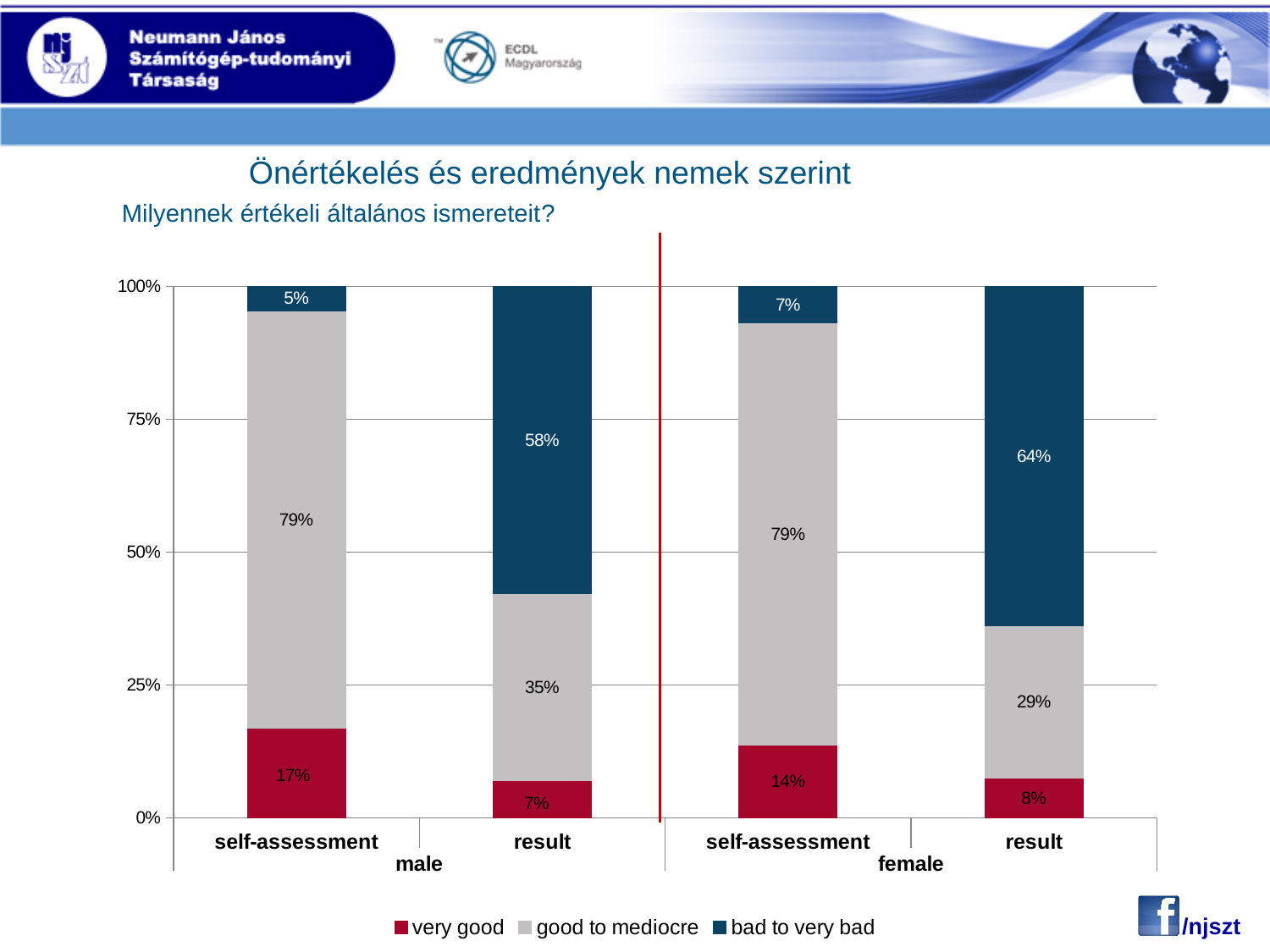
Which bar has the lowest 'very good' value? male result Which legend entry is shown in dark blue? bad to very bad Which is larger: the 'very good' value for male self-assessment or for female self-assessment? male self-assessment What is the 'bad to very bad' value for the female self-assessment bar? 7% How many bars are plotted in the chart? 4 What kind of chart is shown on the slide? stacked bar chart What is the 'bad to very bad' value for the female result bar? 64% What is the difference between the 'bad to very bad' values for the female result and the male result? 6% What is the 'good to mediocre' value for the male result bar? 35% How many series does the legend list? 3 Which bar has the highest 'bad to very bad' value? female result What is the 'very good' value for the male self-assessment bar? 17%